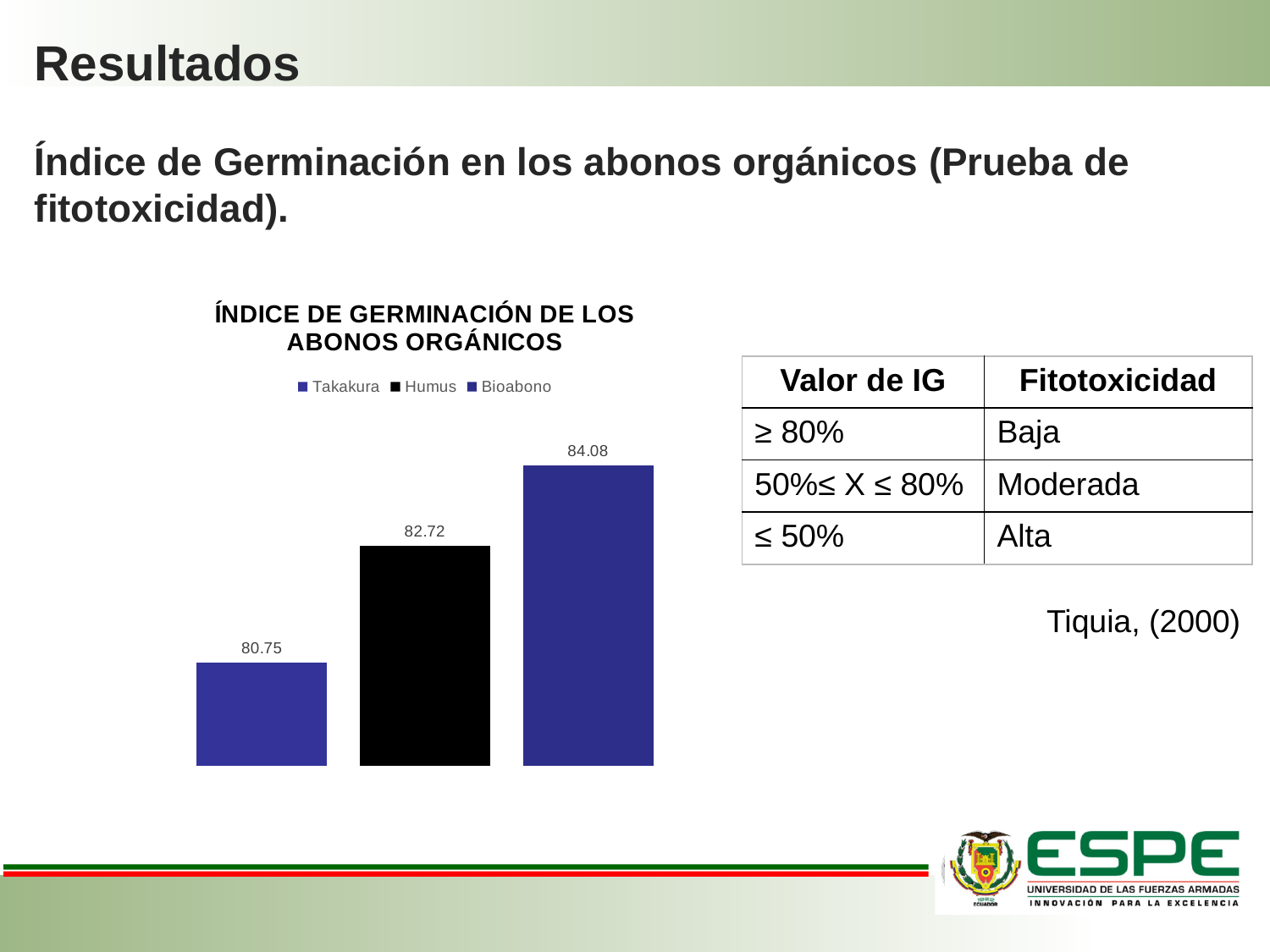
How many bars are shown in the chart? 3 Which organic fertilizer has the lowest germination index? Takakura What is the germination index value for Takakura? 80.75 What type of chart is shown on the slide? Bar chart What is the title of the chart? ÍNDICE DE GERMINACIÓN DE LOS ABONOS ORGÁNICOS What is the difference between the germination index of Bioabono and Takakura? 3.33 What is the germination index value for Humus? 82.72 What is the germination index value for Bioabono? 84.08 How many entries does the chart legend list? 3 What is the difference between the germination index of Humus and Takakura? 1.97 Which organic fertilizer has the highest germination index? Bioabono Which has a higher germination index, Humus or Bioabono? Bioabono